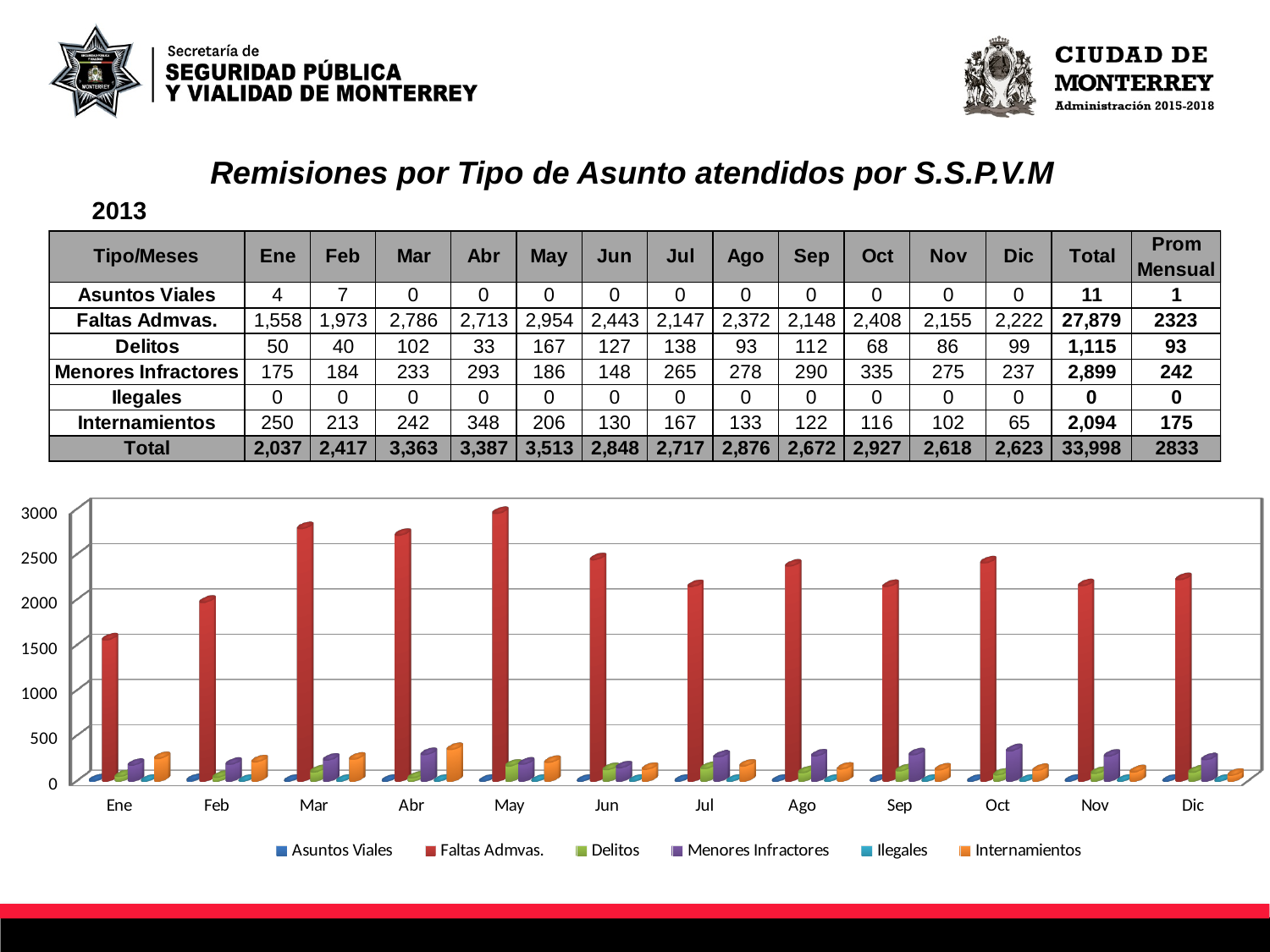
In which month is the Faltas Admvas. bar the highest? May What kind of chart is shown on the slide? bar chart Is the value of Faltas Admvas. for Mar greater or less than 2500? greater How many months are shown along the x axis of the chart? 12 In which month is the Faltas Admvas. bar the lowest? Ene How many series does the chart legend list? 6 Which colour represents Faltas Admvas. in the chart? red What is the value of Faltas Admvas. for May? 2,954 What is the value of Menores Infractores for Oct? 335 What is the difference between Internamientos in Abr and Internamientos in Dic? 283 Is the value of Faltas Admvas. for Ene greater or less than 2000? less In which month is the Internamientos bar the highest? Abr